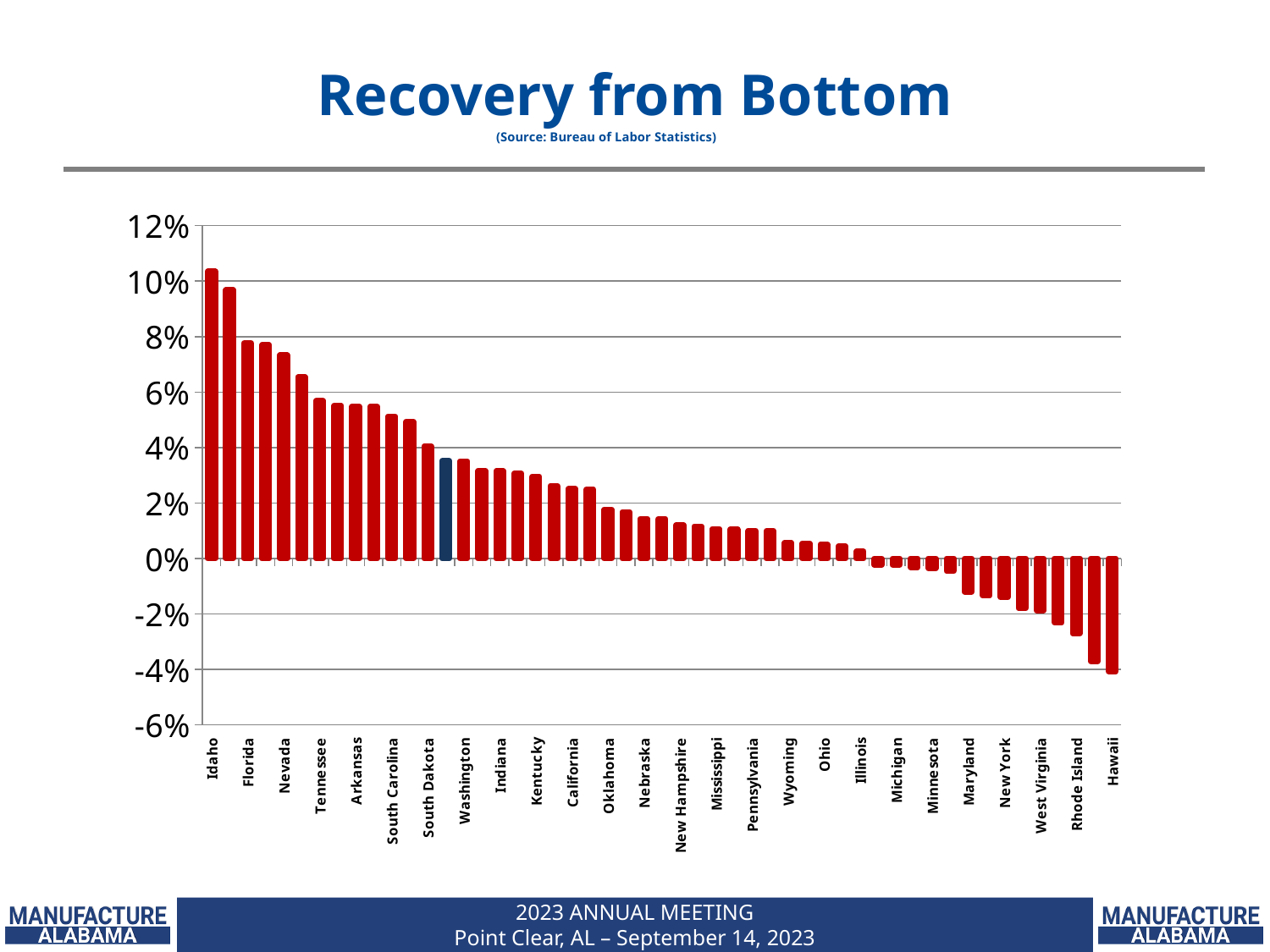
Is the value for Ohio greater or less than 2%? less Is the value for Idaho greater or less than 8%? greater Is the value for Florida greater or less than 8%? less Which state has the highest value in the chart? Idaho Do the values rise or fall moving from left to right along the x axis? fall Which has the larger value, Florida or Nevada? Florida Which state has the lowest value in the chart? Hawaii What source is cited under the chart title? Bureau of Labor Statistics What kind of chart is shown on the slide? bar chart